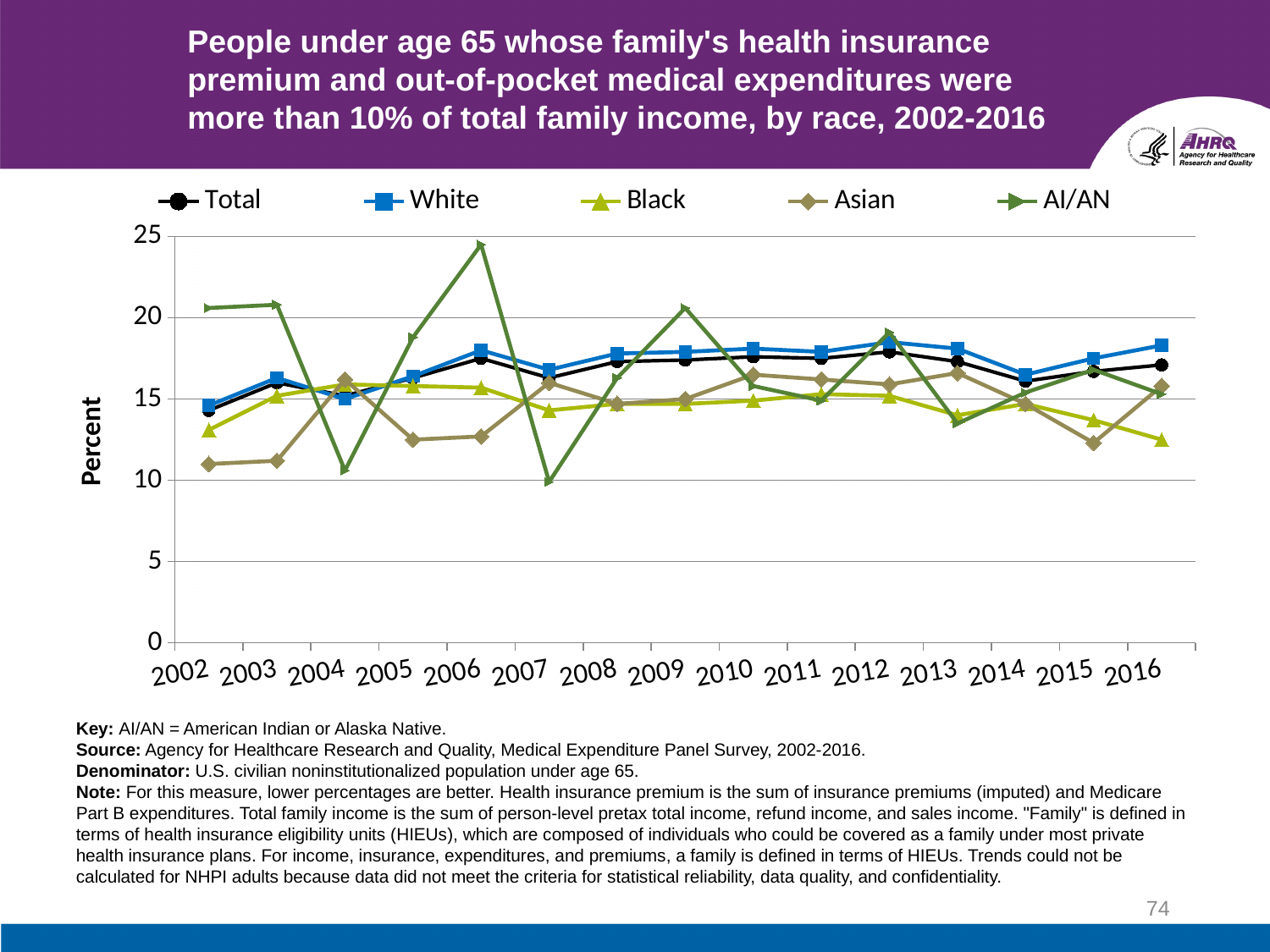
Does the White series rise or fall overall from 2002 to 2016? rise Is the value for AI/AN in 2006 greater or less than 20? greater How many series does the legend list? 5 Which series has the highest value in 2006? AI/AN Which series has the lowest value in 2007? AI/AN How many years are plotted along the x axis? 15 Which series has the lowest value in 2002? Asian Is the value for Asian in 2002 greater or less than 15? less What kind of chart is shown on the slide? line chart What is the label on the y axis? Percent Which is larger in 2002, the value for White or the value for Black? White Is the value for White in 2016 greater or less than 15? greater